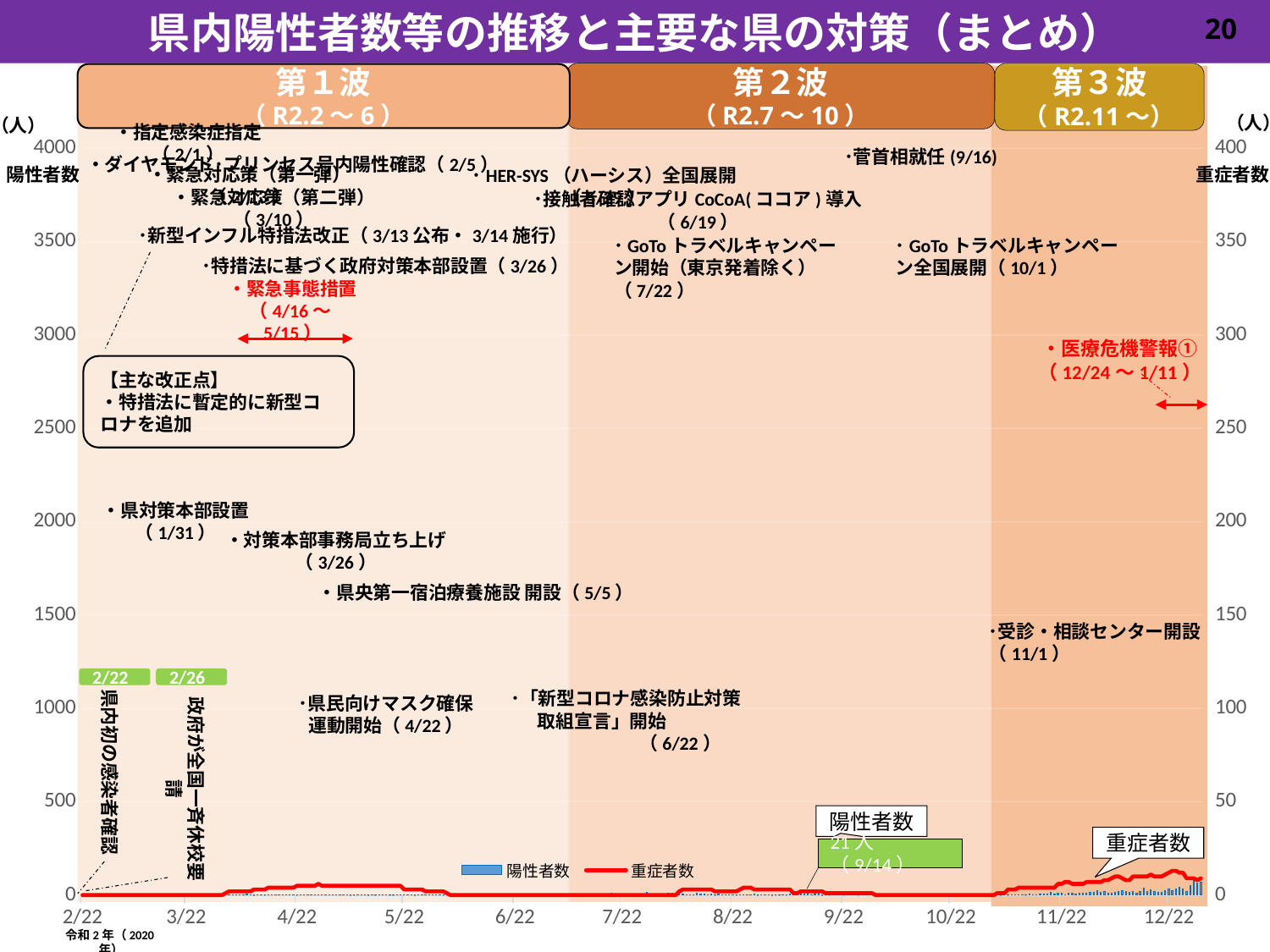
Does the 重症者数 line rise or fall between 11/22 and 12/22? rise Which series is drawn in red? 重症者数 Is the 陽性者数 value at 12/22 greater or less than 500? less Which wave label covers the period R2.7〜10? 第2波 Is the 重症者数 value at 12/22 greater or less than 50? less What kind of chart is used to plot 陽性者数? bar chart How many date ticks are shown along the x axis? 11 Is the 重症者数 value at 6/22 greater or less than 50? less What kind of chart is used to plot 重症者数? line chart How many series does the chart legend list? 2